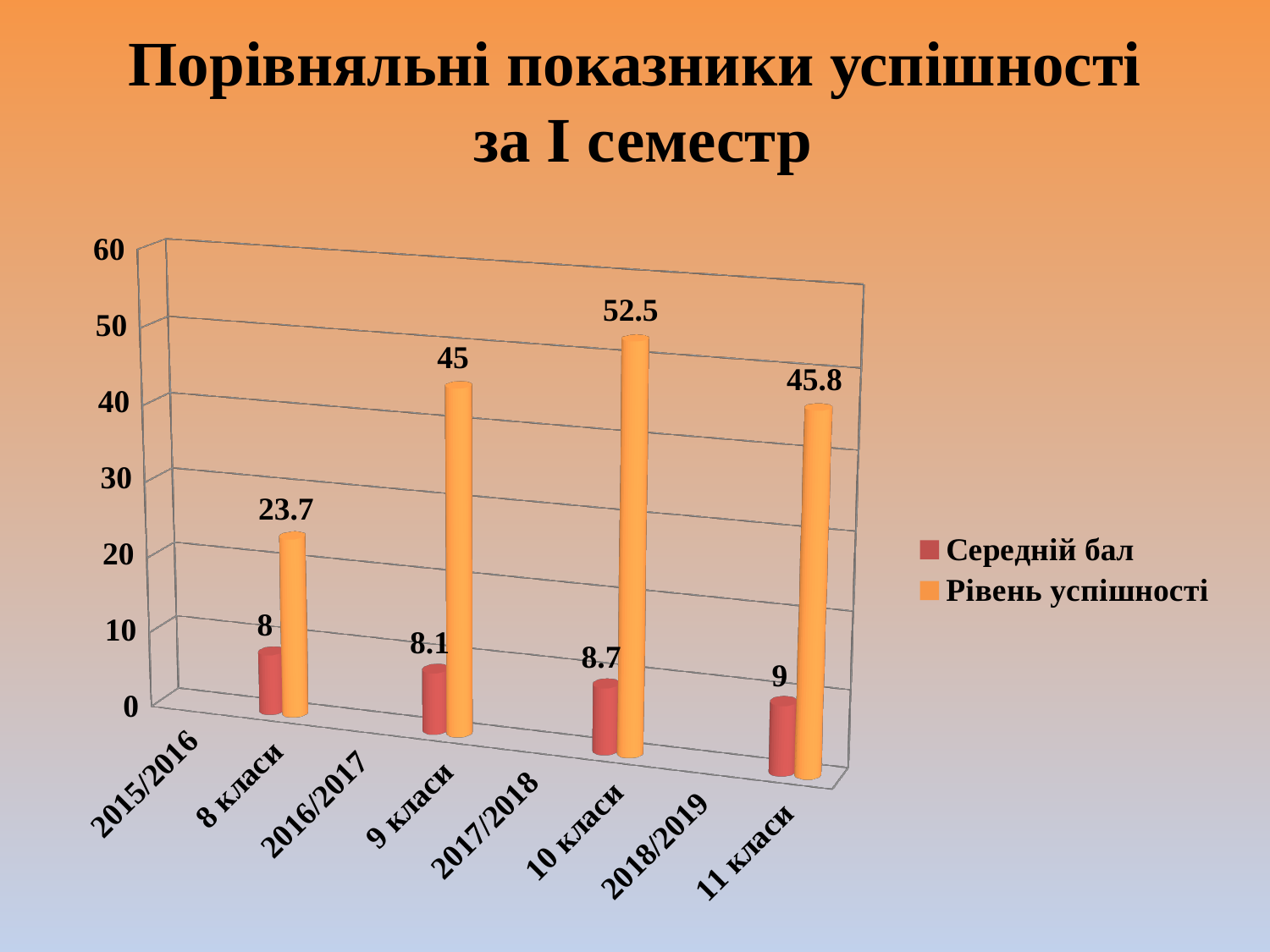
What is the value of Рівень успішності for 2018/2019 11 класи? 45.8 Which category has the lowest Рівень успішності? 2015/2016 8 класи How many categories are shown on the x axis? 8 What kind of chart is shown on the slide? Bar chart What is the value of Рівень успішності for 2017/2018 10 класи? 52.5 How many series does the legend list? 2 What is the value of Середній бал for 2017/2018 10 класи? 8.7 Which is larger: the Рівень успішності for 2016/2017 9 класи or for 2018/2019 11 класи? 2018/2019 11 класи Which category has the highest Середній бал? 2018/2019 11 класи What is the value of Середній бал for 2015/2016 8 класи? 8 What is the difference between the Рівень успішності for 2017/2018 10 класи and 2016/2017 9 класи? 7.5 Which category has the highest Рівень успішності? 2017/2018 10 класи